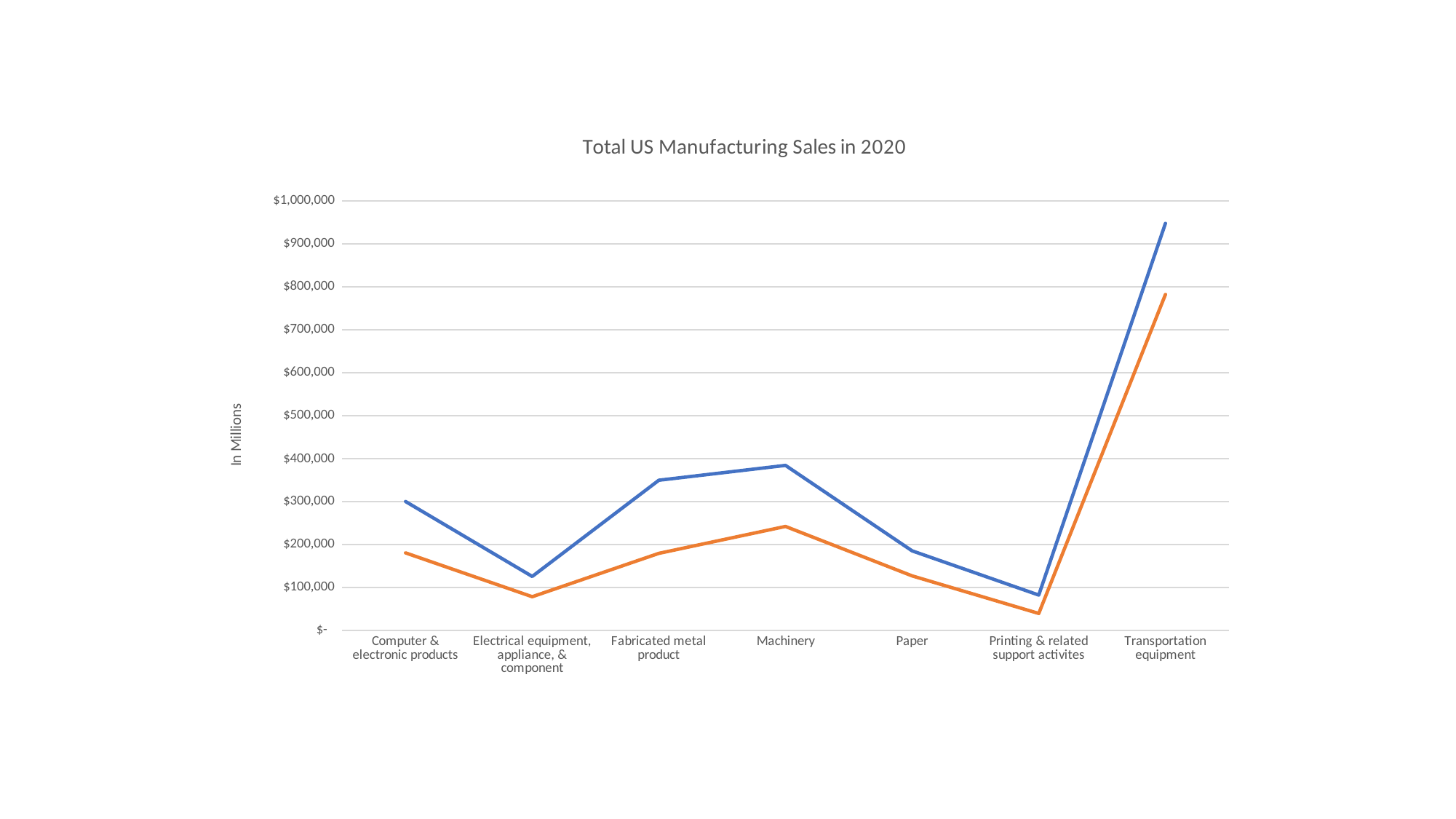
For Machinery, which line has the larger value, the blue line or the orange line? blue line Is the orange line's value for Transportation equipment greater or less than $800,000? less Which category has the highest value for the blue line? Transportation equipment How many lines are plotted on the chart? 2 How many categories are shown on the x axis? 7 Is the blue line's value for Machinery greater or less than $400,000? less What is the title of the chart? Total US Manufacturing Sales in 2020 Which category has the lowest value for the orange line? Printing & related support activites Which category has the lowest value for the blue line? Printing & related support activites What kind of chart is shown on the slide? line chart Is the orange line's value for Printing & related support activites greater or less than $100,000? less